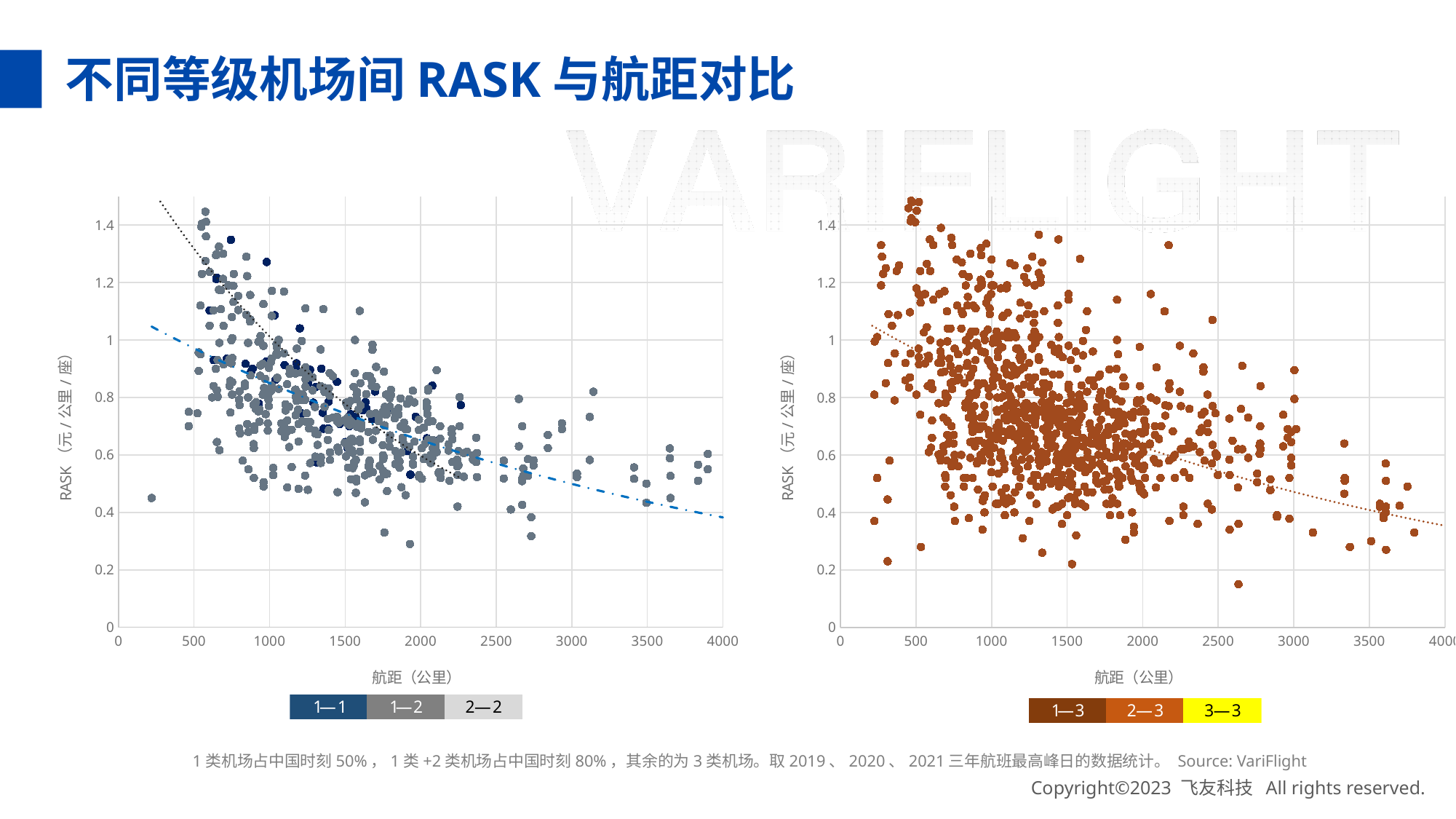
In the right chart, do RASK values generally rise or fall as 航距 (公里) increases? fall How many series does the legend of the right chart list? 3 What are the legend entries of the left chart? 1—1, 1—2, 2—2 In the left chart, do RASK values generally rise or fall as 航距 (公里) increases? fall What is the y-axis label of the right chart? RASK（元 / 公里 / 座） What is the title of the slide containing the two charts? 不同等级机场间 RASK 与航距对比 What kind of chart is the right chart on the slide? scatter chart How many series does the legend of the left chart list? 3 What kind of chart is the left chart on the slide? scatter chart